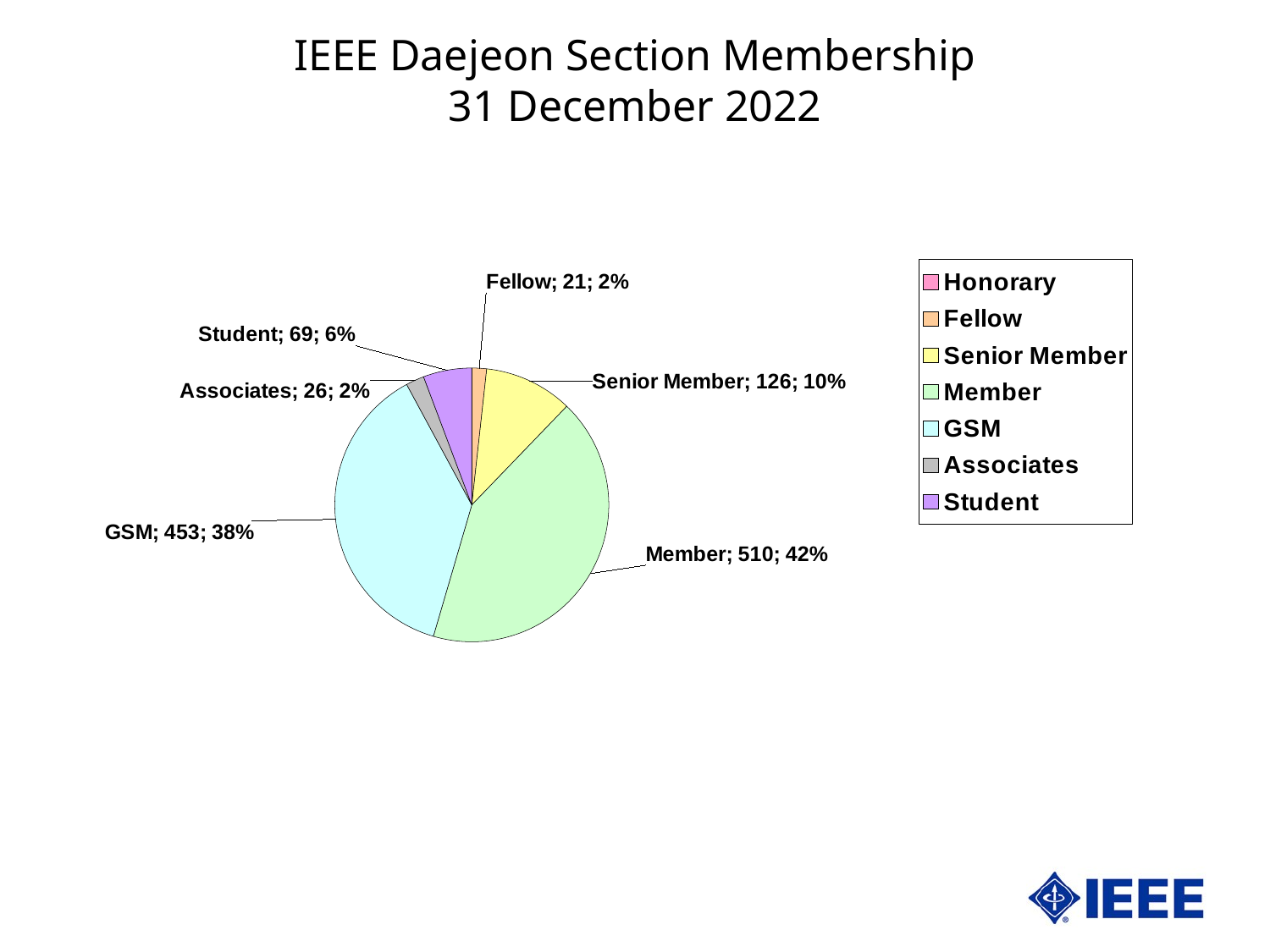
What kind of chart is shown on the slide? pie chart What is the title of the slide containing the chart? IEEE Daejeon Section Membership 31 December 2022 Which is larger, the Student count or the Associates count? Student What share of the pie does the Senior Member slice represent? 10% How many entries does the legend list? 7 How many members are in the GSM category? 453 How many members are in the Student category? 69 How many members are in the Senior Member category? 126 Which category has the largest slice of the pie? Member What is the difference between the Member count and the GSM count? 57 What share of the pie does the GSM slice represent? 38% How many members are in the Member category? 510